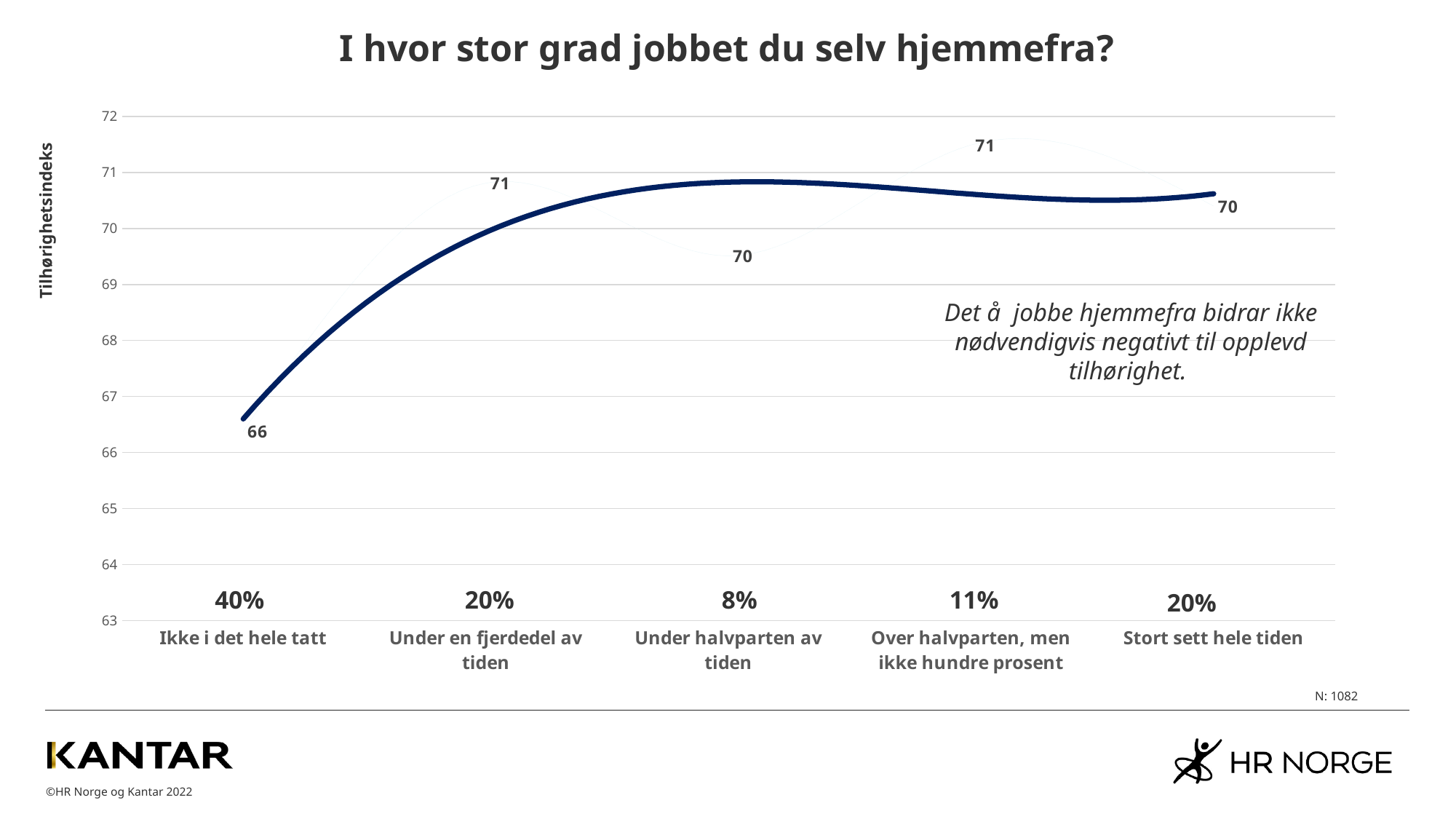
What is the difference between the Tilhørighetsindeks values for "Under en fjerdedel av tiden" and "Ikke i det hele tatt"? 5 What is the Tilhørighetsindeks value for "Under en fjerdedel av tiden"? 71 What is the Tilhørighetsindeks value for "Ikke i det hele tatt"? 66 What kind of chart is shown on the slide? line chart What is the Tilhørighetsindeks value for "Stort sett hele tiden"? 70 Which has a higher Tilhørighetsindeks value: "Ikke i det hele tatt" or "Over halvparten, men ikke hundre prosent"? Over halvparten, men ikke hundre prosent How many categories are shown on the x axis of the chart? 5 What percentage of respondents is shown for the category "Ikke i det hele tatt"? 40% Does the value rise or fall from "Ikke i det hele tatt" to "Under en fjerdedel av tiden"? rise Which category has the lowest Tilhørighetsindeks value? Ikke i det hele tatt Is the value for "Ikke i det hele tatt" greater or less than 67? less What is the Tilhørighetsindeks value for "Under halvparten av tiden"? 70